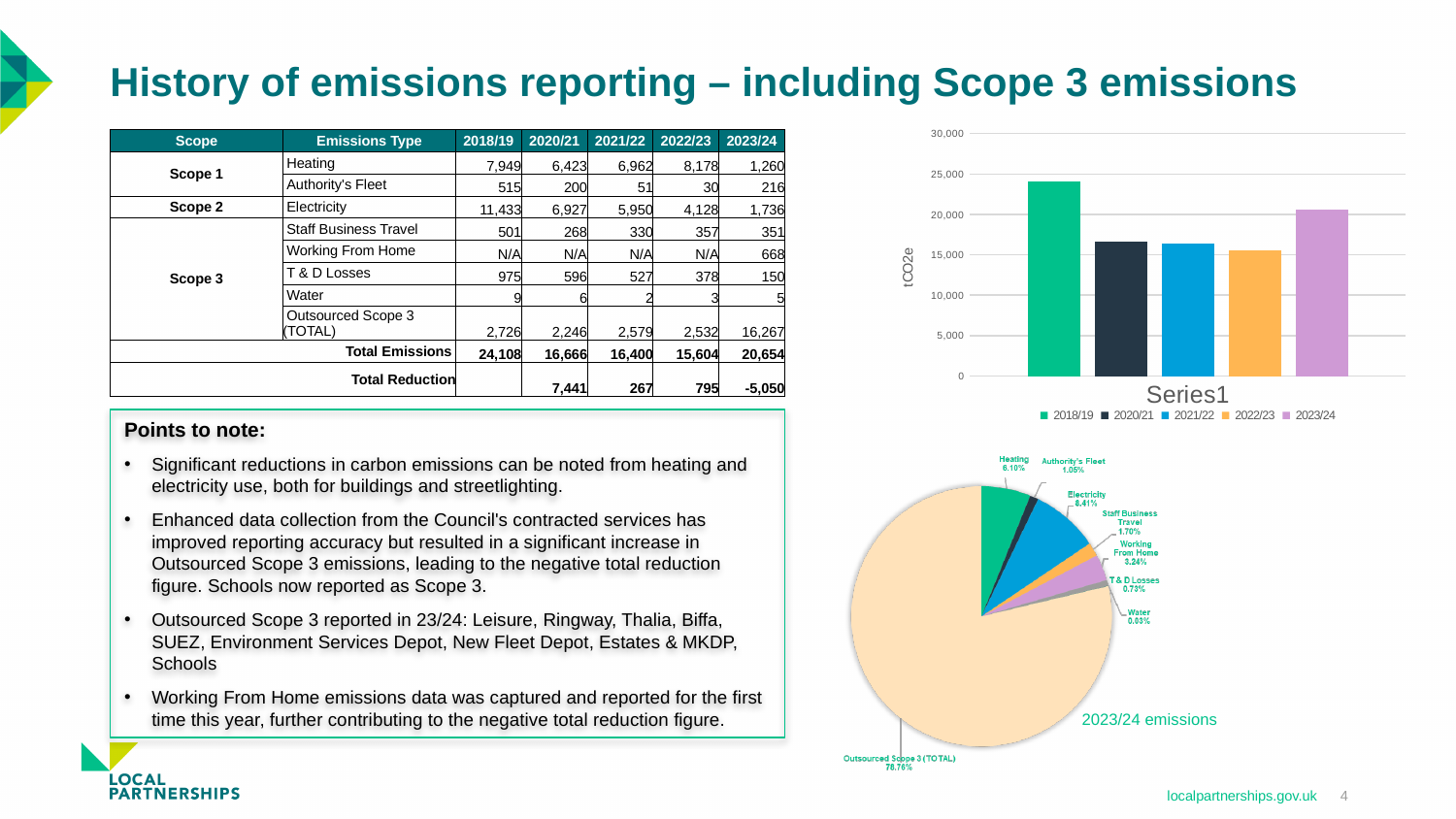
In the bar chart at the top right, which year has the tallest bar? 2018/19 What type of chart is the chart at the top right of the slide? bar chart In the '2023/24 emissions' pie chart, which category has the smallest slice? Water In the '2023/24 emissions' pie chart, what share does Electricity have? 8.41% In the bar chart at the top right, is the value for 2022/23 greater or less than 20,000? less In the '2023/24 emissions' pie chart, what share does Outsourced Scope 3 (TOTAL) have? 78.76% In the bar chart at the top right, which bar is taller, 2018/19 or 2023/24? 2018/19 In the bar chart at the top right, is the value for 2018/19 greater or less than 20,000? greater In the '2023/24 emissions' pie chart, how many slices are there? 8 What type of chart is the '2023/24 emissions' chart at the bottom right of the slide? pie chart In the bar chart at the top right, how many entries does the legend list? 5 In the bar chart at the top right, what is the label on the vertical axis? tCO2e